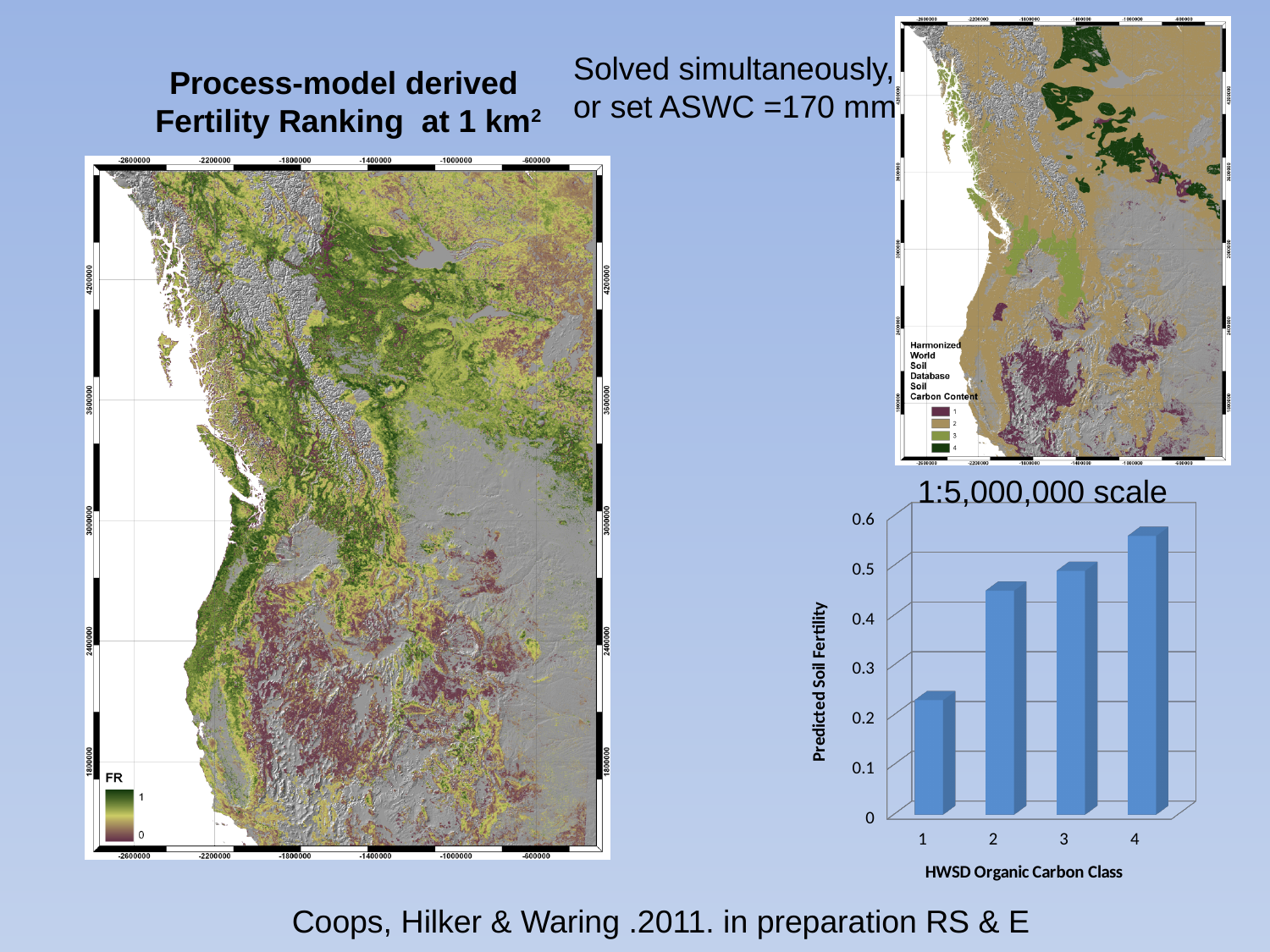
In the bar chart, is the Predicted Soil Fertility for class 4 greater or less than 0.5? greater In the bar chart, which HWSD Organic Carbon Class has the lowest Predicted Soil Fertility? 1 In the bar chart, is the Predicted Soil Fertility for class 2 greater or less than 0.4? greater In the bar chart, does Predicted Soil Fertility rise or fall as the HWSD Organic Carbon Class increases from 1 to 4? rise What kind of chart is shown at the bottom right of the slide? bar chart In the bar chart, which has the larger Predicted Soil Fertility, class 1 or class 4? class 4 In the bar chart, is the Predicted Soil Fertility for class 1 greater or less than 0.3? less What is the label of the vertical axis of the bar chart? Predicted Soil Fertility In the bar chart, how many HWSD Organic Carbon Classes are plotted on the x axis? 4 In the bar chart, which HWSD Organic Carbon Class has the highest Predicted Soil Fertility? 4 What is the label of the horizontal axis of the bar chart? HWSD Organic Carbon Class